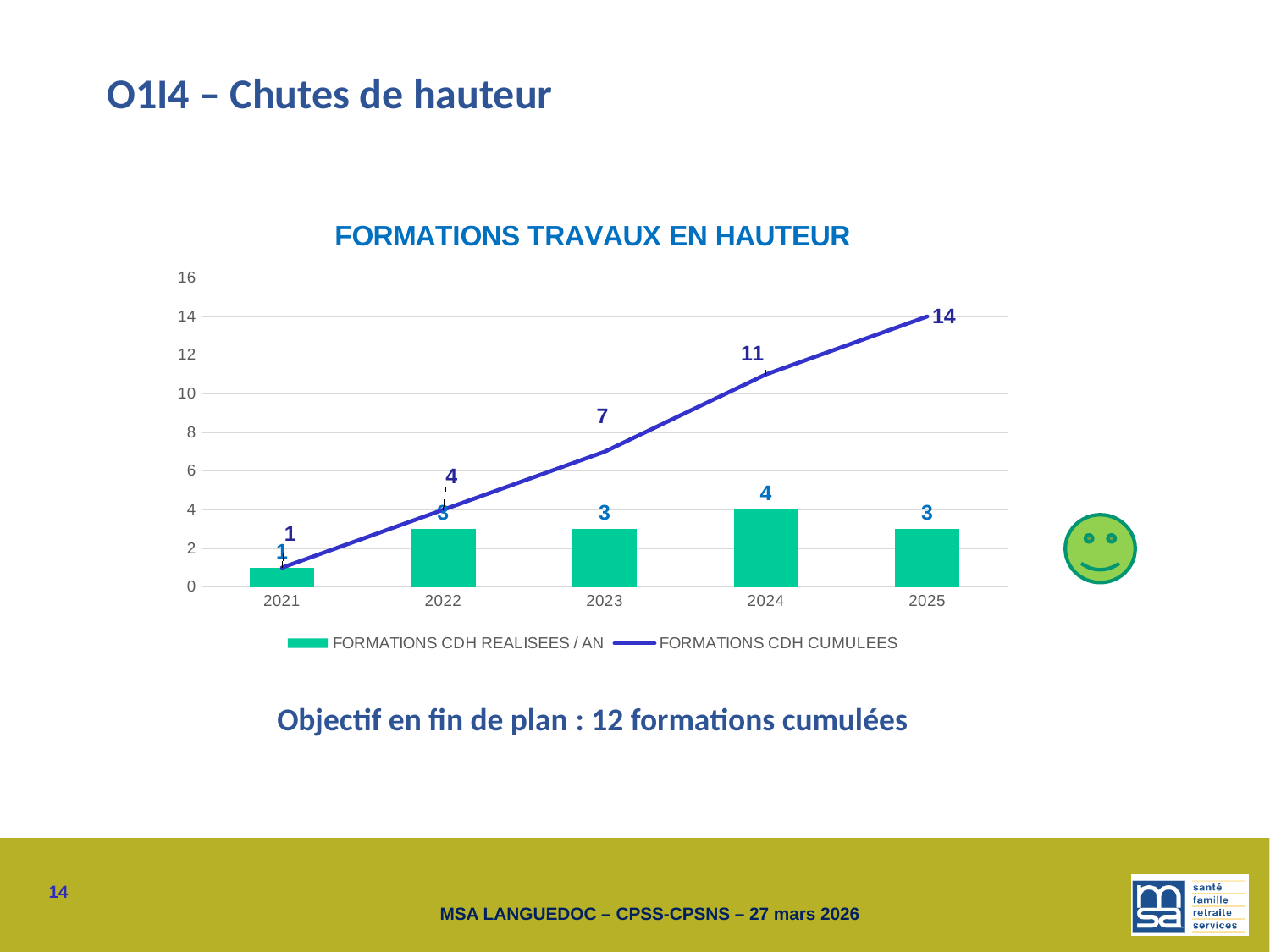
Which year has the lowest value for FORMATIONS CDH REALISEES / AN? 2021 Does the FORMATIONS CDH CUMULEES line rise or fall from 2021 to 2025? rise How many years are shown on the x axis? 5 How many series does the legend list? 2 What is the value of FORMATIONS CDH REALISEES / AN for 2024? 4 Which year has the highest value for FORMATIONS CDH REALISEES / AN? 2024 What is the value of FORMATIONS CDH REALISEES / AN for 2021? 1 Which is larger, the FORMATIONS CDH CUMULEES value for 2022 or for 2023? 2023 What is the value of FORMATIONS CDH CUMULEES for 2023? 7 What is the value of FORMATIONS CDH CUMULEES for 2025? 14 What is the difference between the FORMATIONS CDH CUMULEES values for 2025 and 2024? 3 What is the title of the chart? FORMATIONS TRAVAUX EN HAUTEUR